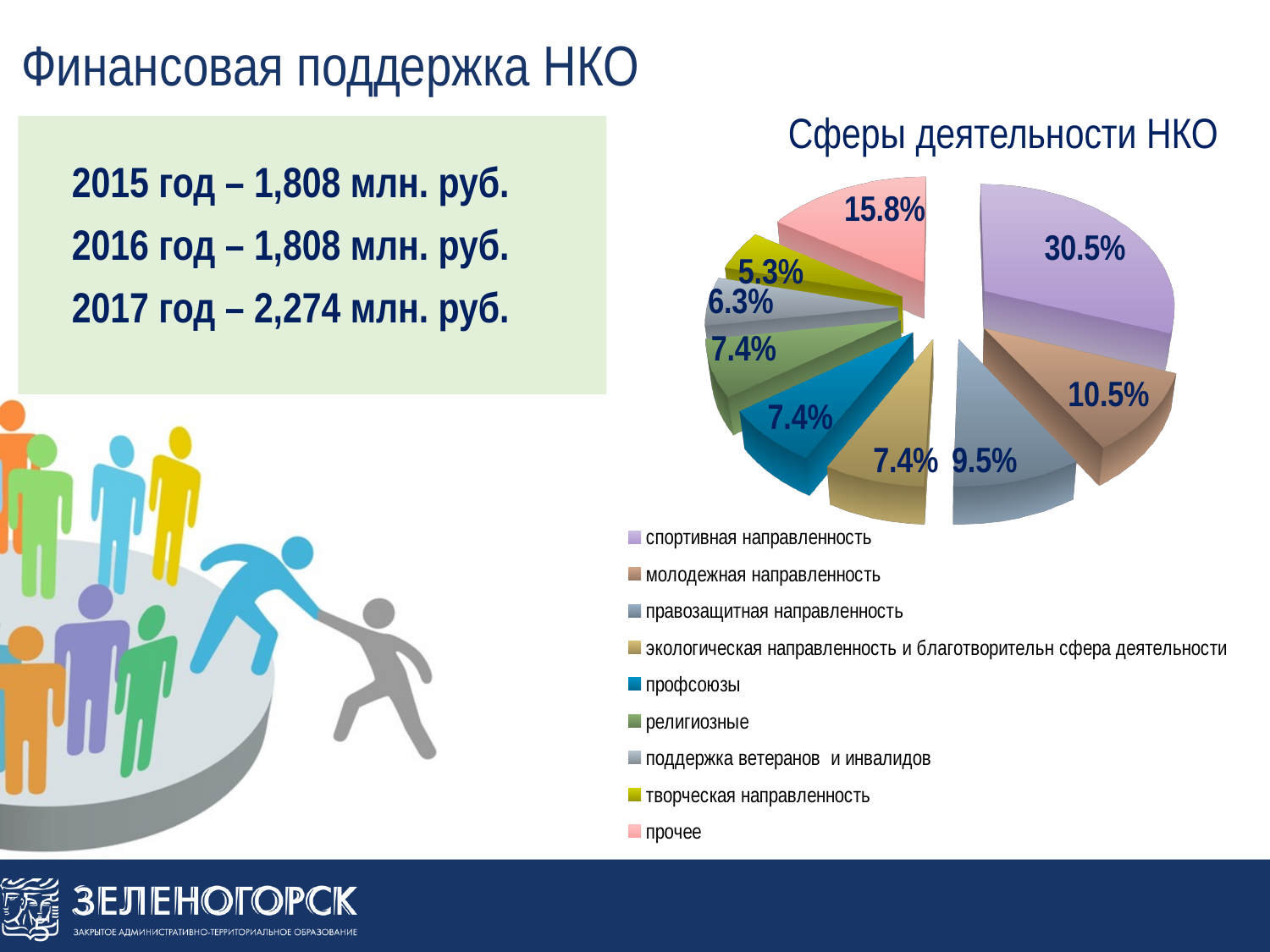
In the pie chart "Сферы деятельности НКО", which is larger: the share of "молодежная направленность" or "правозащитная направленность"? молодежная направленность In the pie chart "Сферы деятельности НКО", how many categories does the legend list? 9 What type of chart is shown under the title "Сферы деятельности НКО"? pie chart In the pie chart "Сферы деятельности НКО", which category has the largest share? спортивная направленность In the pie chart "Сферы деятельности НКО", what share does "спортивная направленность" have? 30.5% In the pie chart "Сферы деятельности НКО", what share does "поддержка ветеранов и инвалидов" have? 6.3% In the pie chart "Сферы деятельности НКО", what share does "творческая направленность" have? 5.3% What is the title of the pie chart on the slide? Сферы деятельности НКО In the pie chart "Сферы деятельности НКО", what is the difference between the shares of "спортивная направленность" and "прочее"? 14.7% In the pie chart "Сферы деятельности НКО", what share does "прочее" have? 15.8% In the pie chart "Сферы деятельности НКО", which category has the smallest share? творческая направленность In the pie chart "Сферы деятельности НКО", what share does "молодежная направленность" have? 10.5%